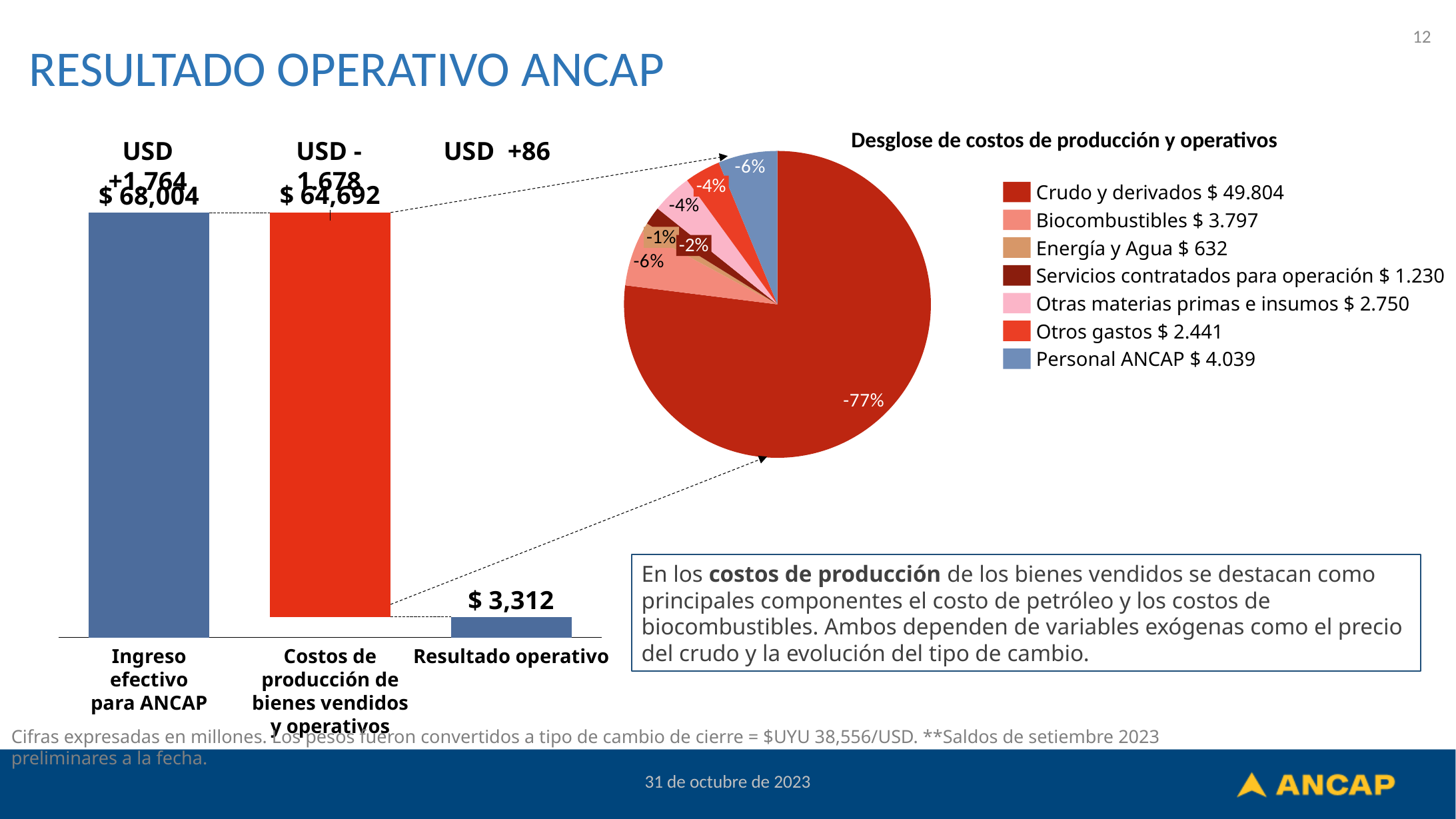
In the pie chart 'Desglose de costos de producción y operativos', which category has the largest slice? Crudo y derivados In the bar chart on the left, how many categories are shown? 3 In the bar chart on the left, which category has the lowest value? Resultado operativo In the bar chart on the left, what is the value for Ingreso efectivo para ANCAP? $ 68,004 In the pie chart 'Desglose de costos de producción y operativos', what percentage is shown for the Personal ANCAP slice? -6% In the bar chart on the left, what is the value for Resultado operativo? $ 3,312 In the pie chart 'Desglose de costos de producción y operativos', which is larger: Biocombustibles or Otros gastos? Biocombustibles In the bar chart on the left, what is the difference between Ingreso efectivo para ANCAP and Costos de producción de bienes vendidos y operativos? $ 3,312 In the pie chart 'Desglose de costos de producción y operativos', how many categories does the legend list? 7 In the pie chart 'Desglose de costos de producción y operativos', what is the value for Crudo y derivados in the legend? $ 49.804 In the pie chart 'Desglose de costos de producción y operativos', which category has the smallest slice? Energía y Agua What kind of chart is the chart on the left of the slide? Bar chart